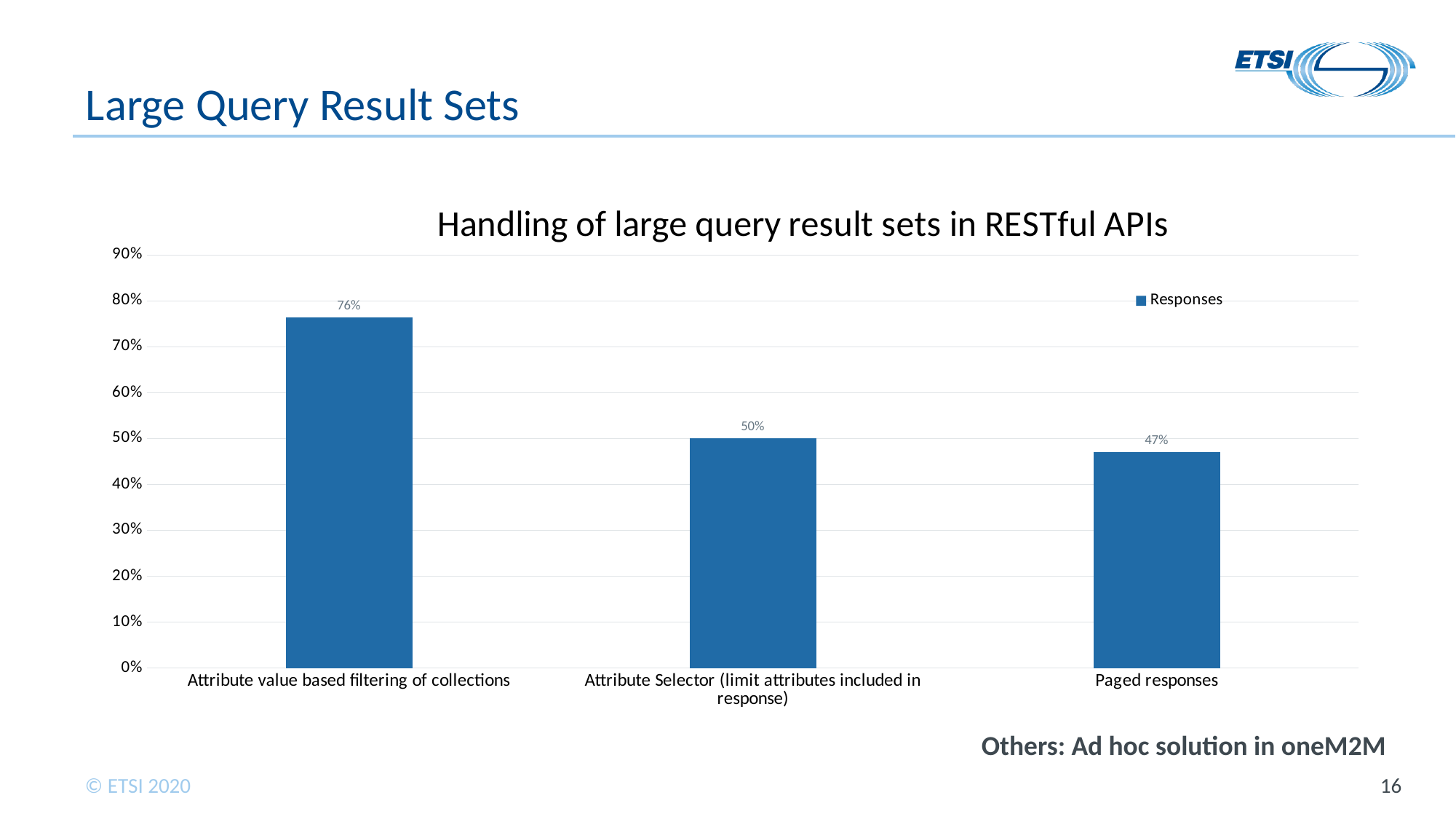
Is the value for Paged responses greater or less than 50%? less What is the value for Attribute Selector (limit attributes included in response)? 50% Which is larger, the value for Attribute value based filtering of collections or the value for Attribute Selector (limit attributes included in response)? Attribute value based filtering of collections Which category has the lowest value? Paged responses What is the title of the chart? Handling of large query result sets in RESTful APIs What is the value for Paged responses? 47% What is the difference between the values for Attribute value based filtering of collections and Paged responses? 29% Which category has the highest value? Attribute value based filtering of collections What kind of chart is shown on the slide? bar chart What is the value for Attribute value based filtering of collections? 76% What is the difference between the values for Attribute Selector (limit attributes included in response) and Paged responses? 3% How many categories are shown in the chart? 3